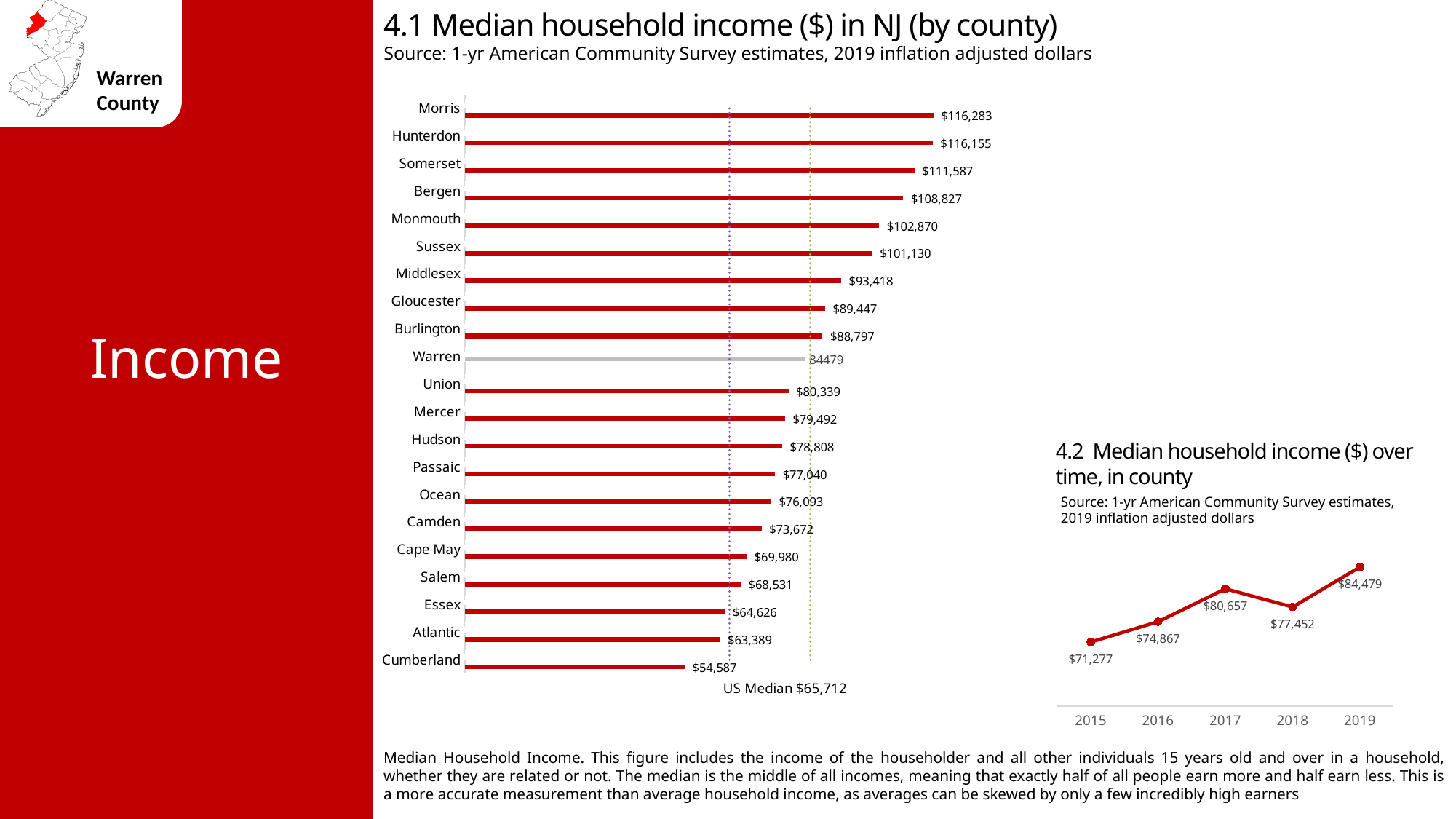
In chart 4.1, what is the median household income for Morris County? $116,283 In chart 4.1, which county has a higher median household income, Warren or Union? Warren In chart 4.1, what US median value is noted below the bars? $65,712 In chart 4.1, how many counties are shown? 21 In chart 4.1, which county has the lowest median household income? Cumberland In chart 4.2, is the median household income in 2018 higher or lower than in 2017? Lower In chart 4.2, which year has the highest median household income? 2019 In chart 4.2, what was the median household income in 2017? $80,657 In chart 4.2, what is the difference between the 2019 and 2015 median household income? $13,202 What kind of chart is chart 4.1? Bar chart In chart 4.1, what is the difference between the median household income of Morris and Cumberland? $61,696 In chart 4.1, what is the median household income for Warren County? 84479